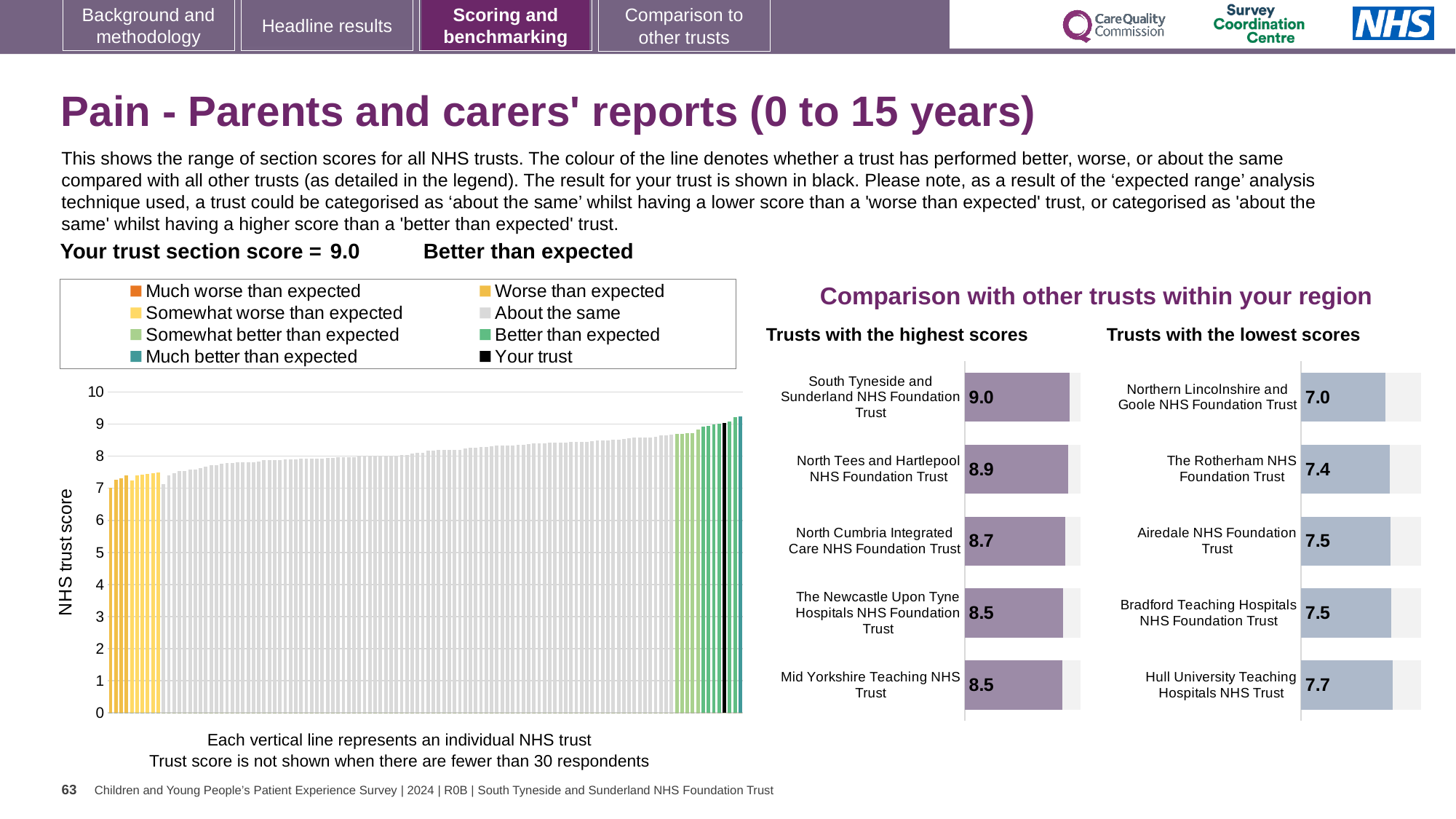
In the large chart on the left, do the trust scores rise or fall from left to right? Rise In the 'Trusts with the lowest scores' chart, which trust has the lowest score? Northern Lincolnshire and Goole NHS Foundation Trust In the 'Trusts with the highest scores' chart, which trust has the highest score? South Tyneside and Sunderland NHS Foundation Trust What type of chart is the large chart on the left showing NHS trust scores? Bar chart In the large chart on the left, are the yellow 'Worse than expected' bars greater or less than 8? less How many trusts are listed in the 'Trusts with the lowest scores' chart? 5 In the 'Trusts with the highest scores' chart, what is the difference between the scores of South Tyneside and Sunderland NHS Foundation Trust and North Cumbria Integrated Care NHS Foundation Trust? 0.3 In the 'Trusts with the lowest scores' chart, what is the score for The Rotherham NHS Foundation Trust? 7.4 In the 'Trusts with the lowest scores' chart, which has the higher score: Hull University Teaching Hospitals NHS Trust or Airedale NHS Foundation Trust? Hull University Teaching Hospitals NHS Trust In the 'Trusts with the highest scores' chart, what is the score for North Tees and Hartlepool NHS Foundation Trust? 8.9 What is the y-axis label of the large chart on the left? NHS trust score How many entries does the legend of the large chart on the left list? 8